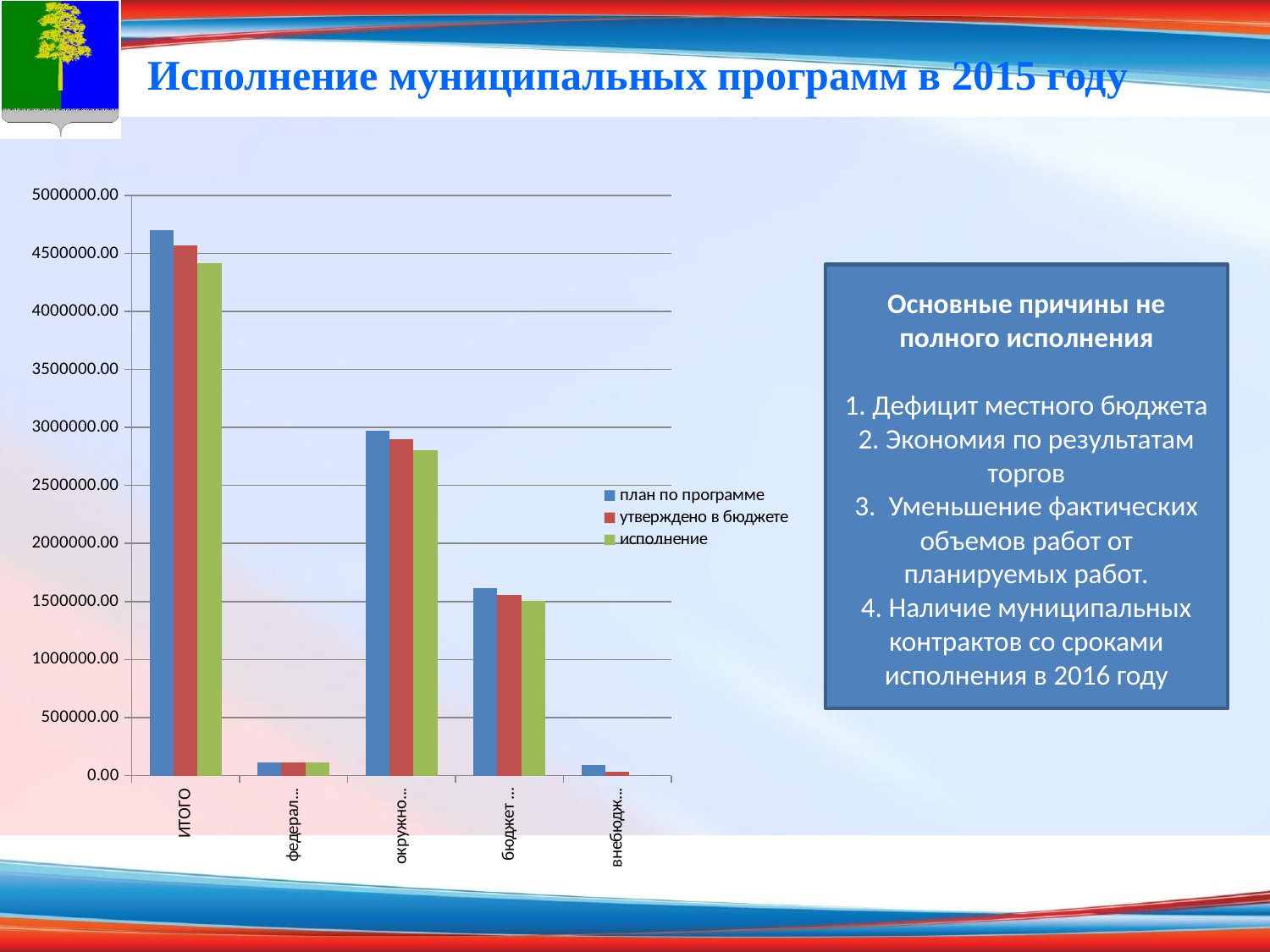
Is the value of 'план по программе' for ИТОГО greater or less than 4500000.00? greater What are the three series listed in the chart legend? план по программе, утверждено в бюджете, исполнение How many series does the chart legend list? 3 Is the value of 'план по программе' for the fourth category (бюджет ...) greater or less than 1000000.00? greater What kind of chart is shown on the slide? bar chart Is the value of 'исполнение' for ИТОГО greater or less than 4500000.00? less What is the title of the slide containing the chart? Исполнение муниципальных программ в 2015 году For 'план по программе', which is larger: the third category (окружно...) or the fourth category (бюджет ...)? окружно... Which category has the highest value for the series 'план по программе'? ИТОГО How many categories are shown on the x axis of the chart? 5 For ИТОГО, which is larger: 'план по программе' or 'исполнение'? план по программе